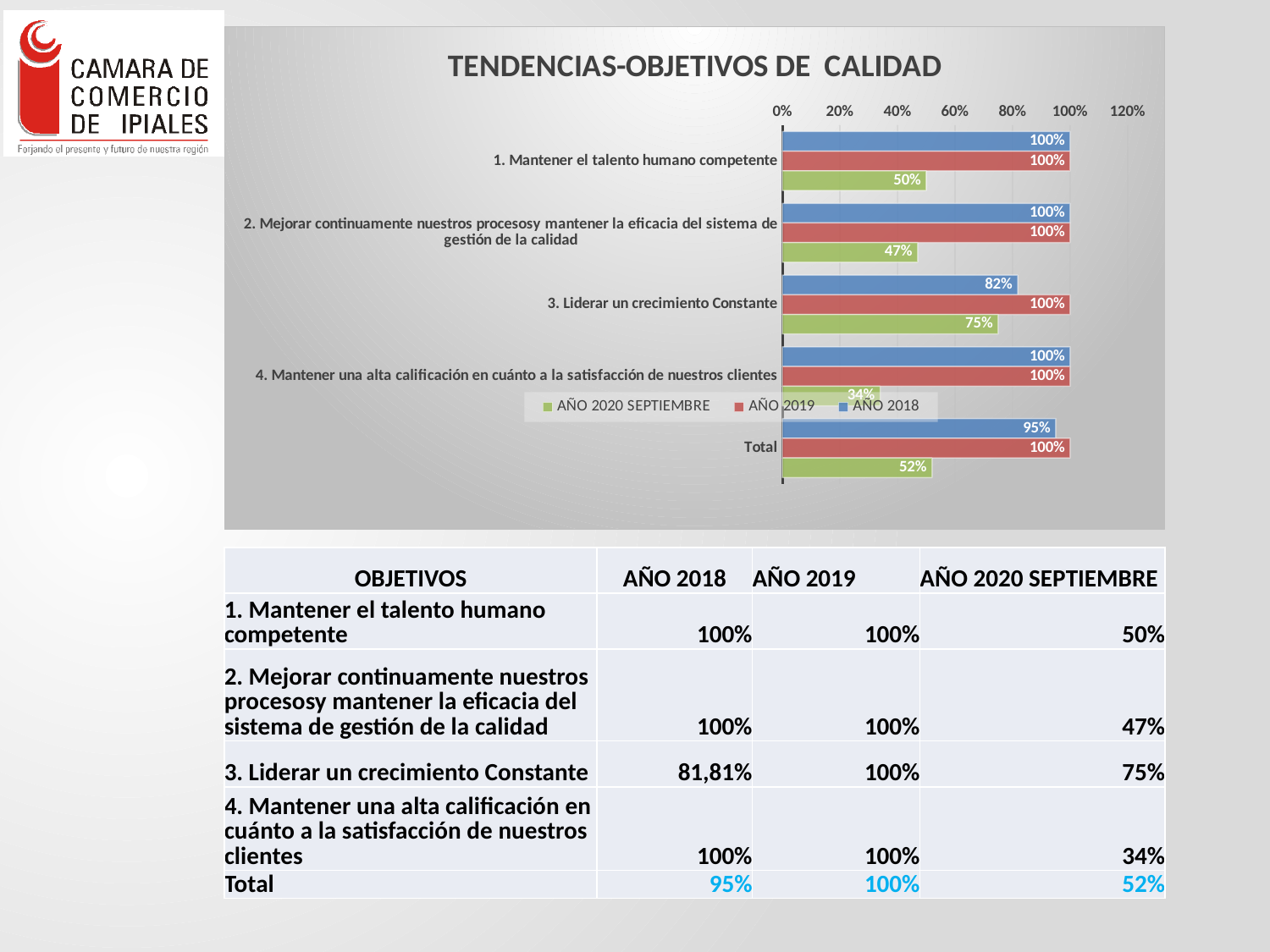
What is the AÑO 2020 SEPTIEMBRE value for 'Total'? 52% What is the AÑO 2018 value for '3. Liderar un crecimiento Constante'? 82% What kind of chart is shown on the slide? bar chart Which category has the highest AÑO 2020 SEPTIEMBRE value? 3. Liderar un crecimiento Constante What is the difference between the AÑO 2019 and AÑO 2020 SEPTIEMBRE values for '2. Mejorar continuamente nuestros procesosy mantener la eficacia del sistema de gestión de la calidad'? 53% What is the title of the chart? TENDENCIAS-OBJETIVOS DE CALIDAD What is the AÑO 2020 SEPTIEMBRE value for '1. Mantener el talento humano competente'? 50% Which category has the lowest AÑO 2020 SEPTIEMBRE value? 4. Mantener una alta calificación en cuánto a la satisfacción de nuestros clientes For 'Total', which is larger: the AÑO 2018 value or the AÑO 2020 SEPTIEMBRE value? AÑO 2018 How many categories are plotted on the chart? 5 How many series does the chart legend list? 3 Which colour represents the AÑO 2019 series in the chart? red